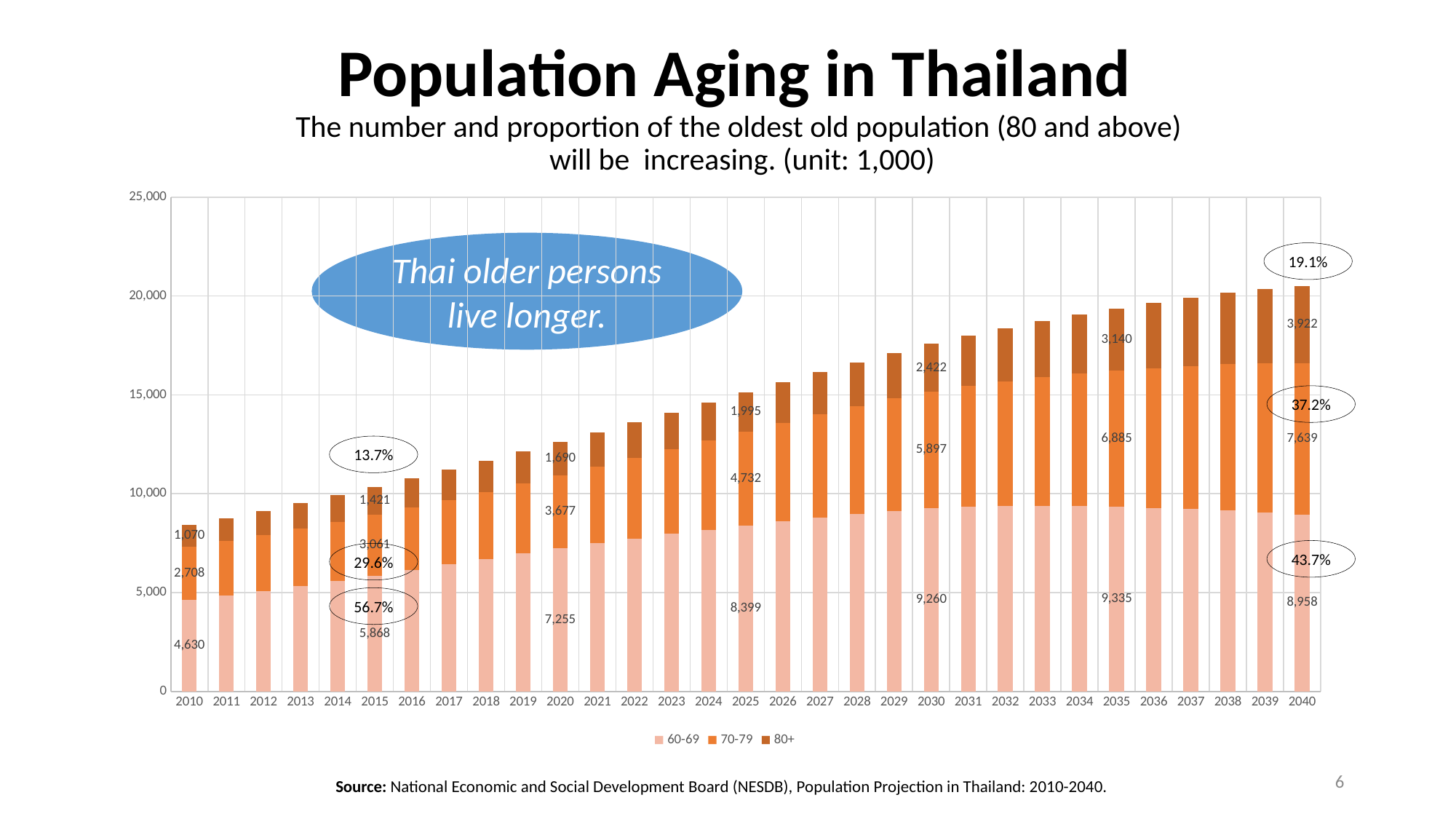
What is the total of the stacked bar for 2010? 8,408 What is the value for the 60-69 group in 2010? 4,630 Is the total bar for 2030 greater or less than 15,000? greater What is the difference between the 80+ value in 2040 and the 80+ value in 2010? 2,852 What is the value for the 70-79 group in 2025? 4,732 Which is larger in 2040, the 60-69 value or the 70-79 value? 60-69 What percentage share is shown for the 80+ group in 2040? 19.1% What is the total of the stacked bar for 2040? 20,519 How many series does the legend list? 3 Does the total height of the bars rise or fall from 2010 to 2040? rise What type of chart is shown on the slide? stacked bar chart What is the value for the 80+ group in 2040? 3,922